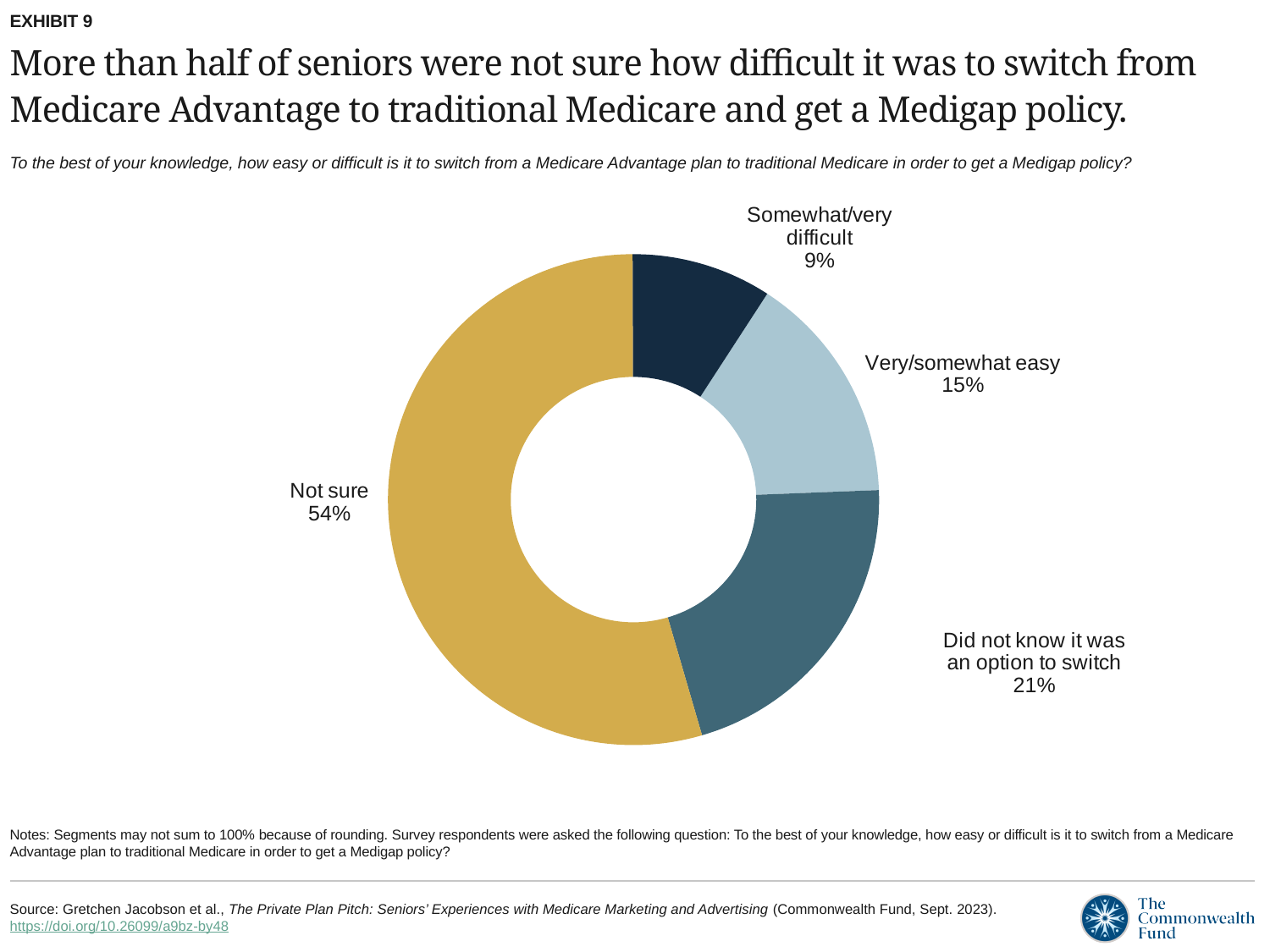
Which response category has the largest share of the chart? Not sure What share of respondents said switching was very/somewhat easy? 15% How many response categories are shown in the chart? 4 What is the difference in percentage points between 'Very/somewhat easy' and 'Somewhat/very difficult'? 6 What percentage of seniors said they were not sure how difficult it was to switch? 54% How many percentage points higher is 'Not sure' than 'Did not know it was an option to switch'? 33 Which response category has the smallest share of the chart? Somewhat/very difficult What colour is the 'Not sure' segment of the chart? Gold/yellow What percentage of respondents said switching was somewhat/very difficult? 9% What percentage of seniors did not know it was an option to switch? 21% What kind of chart is shown on the slide? Donut (pie) chart Which is larger: the share for 'Very/somewhat easy' or the share for 'Did not know it was an option to switch'? Did not know it was an option to switch